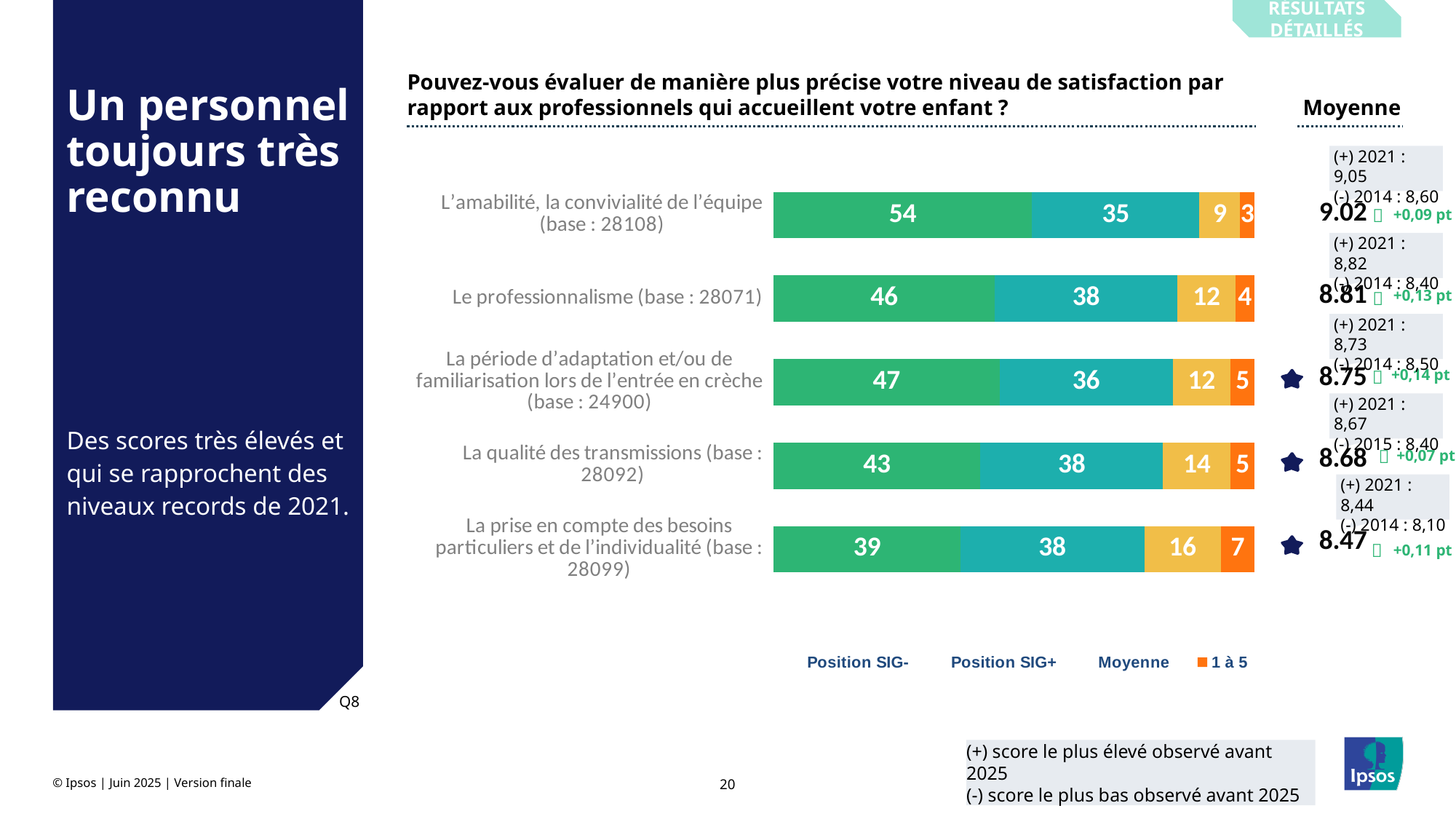
What question is the chart based on, as shown in the title above it? Pouvez-vous évaluer de manière plus précise votre niveau de satisfaction par rapport aux professionnels qui accueillent votre enfant ? What is the "Moyenne" value shown for "La période d'adaptation et/ou de familiarisation lors de l'entrée en crèche"? 8.75 Which has a larger yellow (third) segment: "La qualité des transmissions" or "Le professionnalisme"? La qualité des transmissions How many categories (items) are plotted in the chart? 5 What is the value of the orange "1 à 5" segment for "La prise en compte des besoins particuliers et de l'individualité"? 7 What is the value of the first (green) segment for "L'amabilité, la convivialité de l'équipe"? 54 Which category has the highest value in the first (green) segment? L'amabilité, la convivialité de l'équipe What is the total of the stacked bar for "Le professionnalisme"? 100 What is the value of the second (teal) segment for "Le professionnalisme"? 38 What type of chart is shown on the slide? stacked bar chart What is the difference between the green segment values of "L'amabilité, la convivialité de l'équipe" and "La qualité des transmissions"? 11 Which category has the lowest value in the first (green) segment? La prise en compte des besoins particuliers et de l'individualité